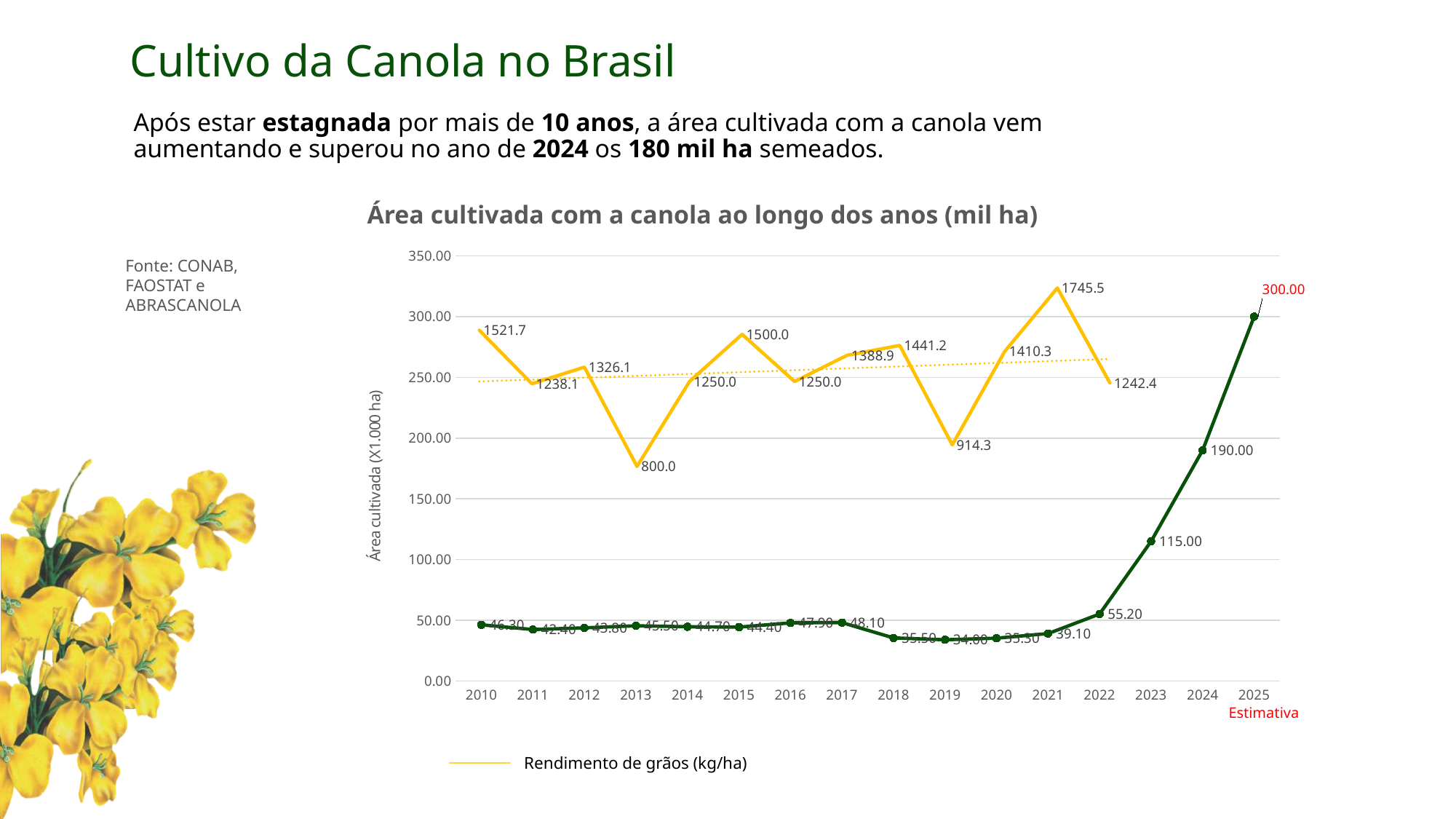
In which year is the grain yield (yellow line) highest? 2021 Does the cultivated area (green line) rise or fall from 2022 to 2025? rises In which year is the grain yield (yellow line) lowest? 2013 What is the estimated cultivated area value plotted for 2025? 300.00 What is the grain yield value labelled for 2010? 1521.7 What is the grain yield (Rendimento de grãos) value labelled for 2021? 1745.5 What is the difference between the cultivated area values for 2024 and 2023? 75.00 What kind of chart is shown on the slide? line chart What is the cultivated area value plotted for 2024? 190.00 How many years are shown on the x axis? 16 Which year has the larger cultivated area value, 2021 or 2022? 2022 What series name is listed in the chart legend? Rendimento de grãos (kg/ha)